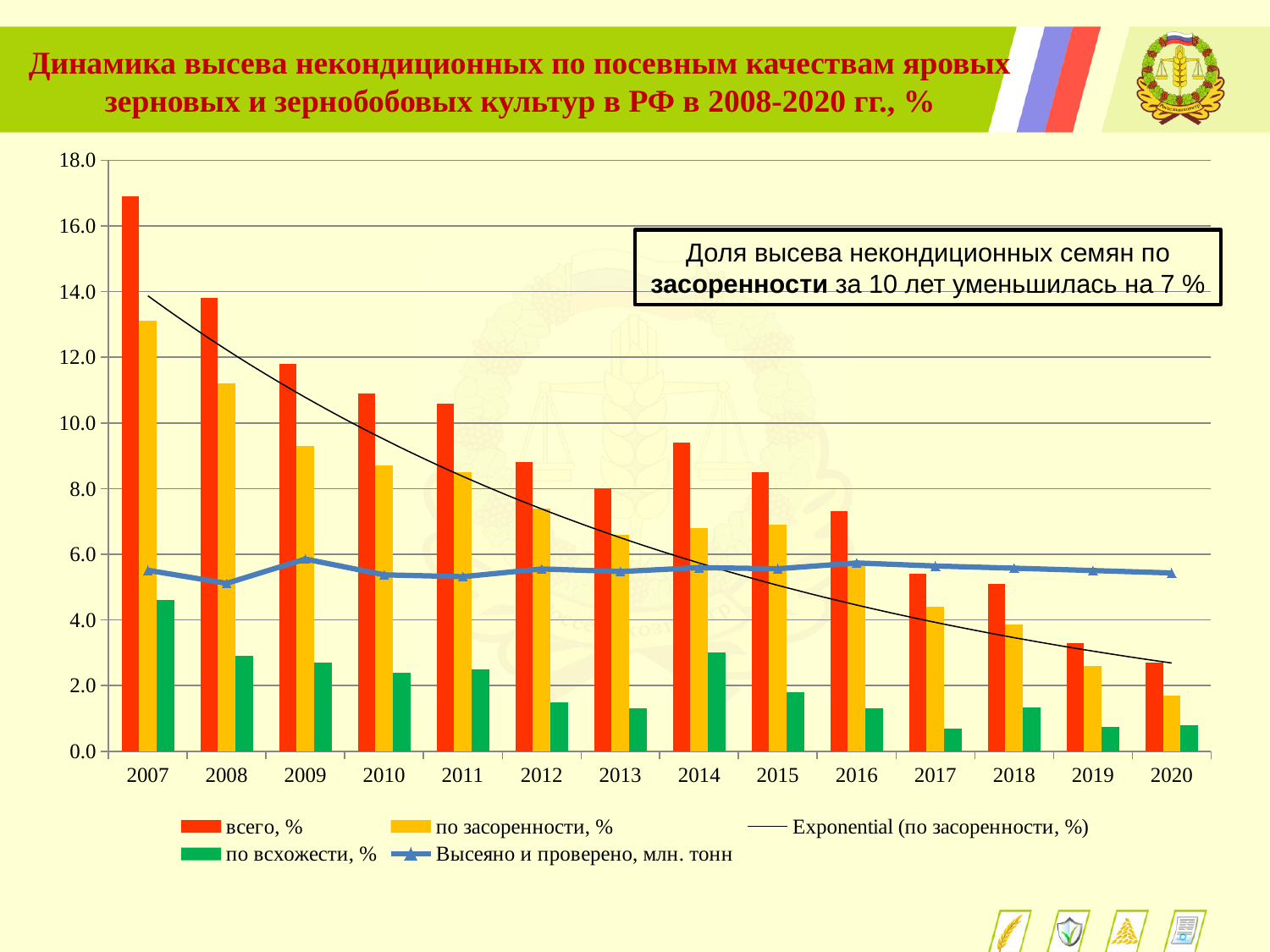
In which year is the value of the "по всхожести, %" series highest? 2007 How many years are shown along the x axis of the chart? 14 Which is larger: the "всего, %" value in 2009 or in 2010? 2009 How many entries does the chart legend list? 5 Which series in the legend is measured in million tonnes (млн. тонн)? Высеяно и проверено, млн. тонн Is the value for "по засоренности, %" in 2007 greater or less than 12.0? greater In which year is the value of the "всего, %" series highest? 2007 Is the value for "всего, %" in 2007 greater or less than 16.0? greater What kind of chart is shown on the slide? combination bar and line chart Do the values of the "всего, %" series generally rise or fall from 2007 to 2020? fall Is the value for "всего, %" in 2020 greater or less than 4.0? less In which year is the value of the "всего, %" series lowest? 2020